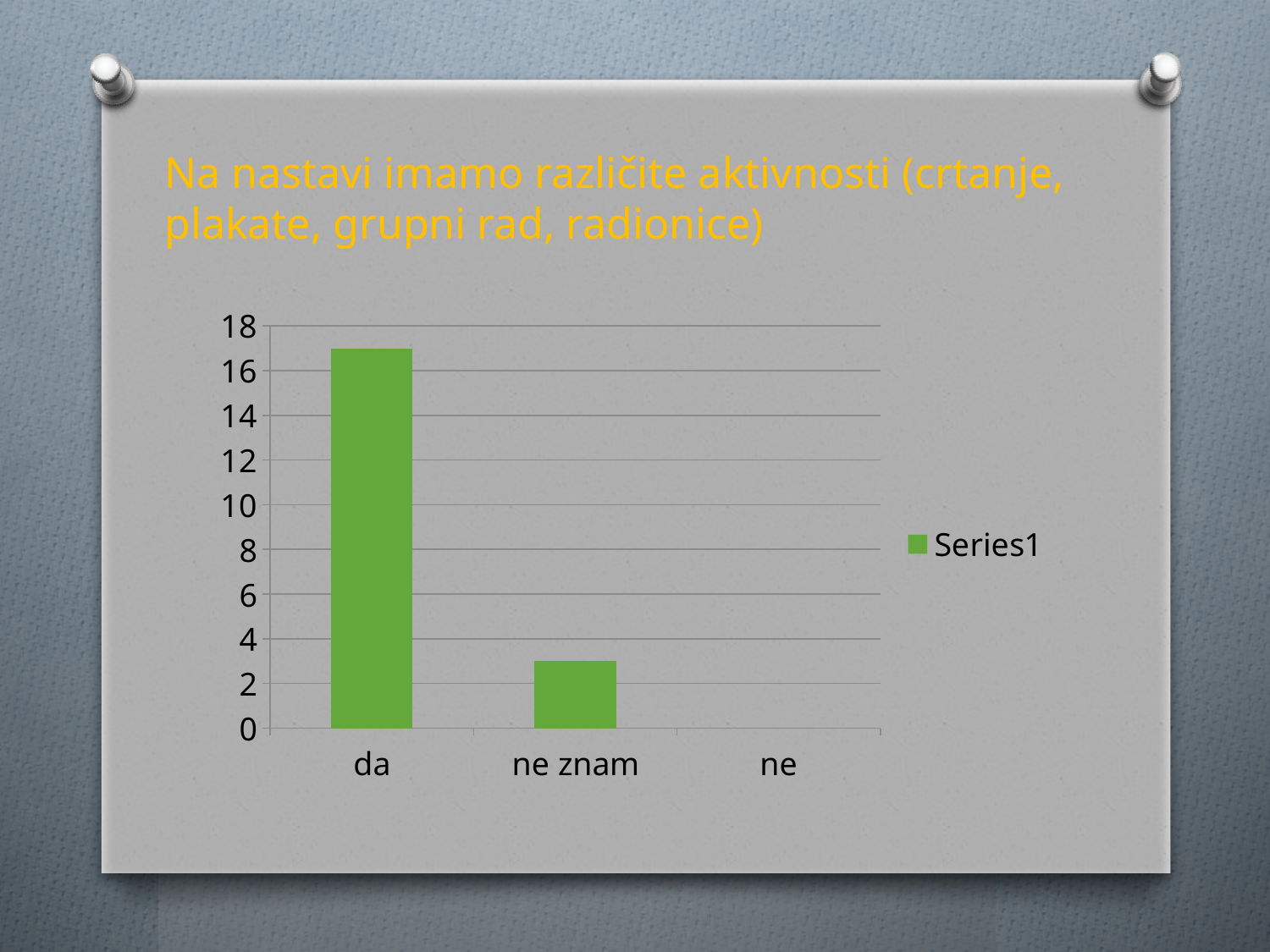
Which category has the highest value in the chart? da What is the value for 'ne' in the chart? 0 Is the value for 'ne znam' greater or less than 4? less How many categories are shown on the x axis of the chart? 3 What kind of chart is shown on the slide? bar chart What is the name of the series listed in the chart's legend? Series1 Is the value for 'da' greater or less than 16? greater Is the value for 'da' greater or less than 10? greater Do the values rise or fall from left to right along the x axis? fall Which category has the lowest value in the chart? ne Which is larger, the value for 'da' or the value for 'ne znam'? da How many series does the chart's legend list? 1